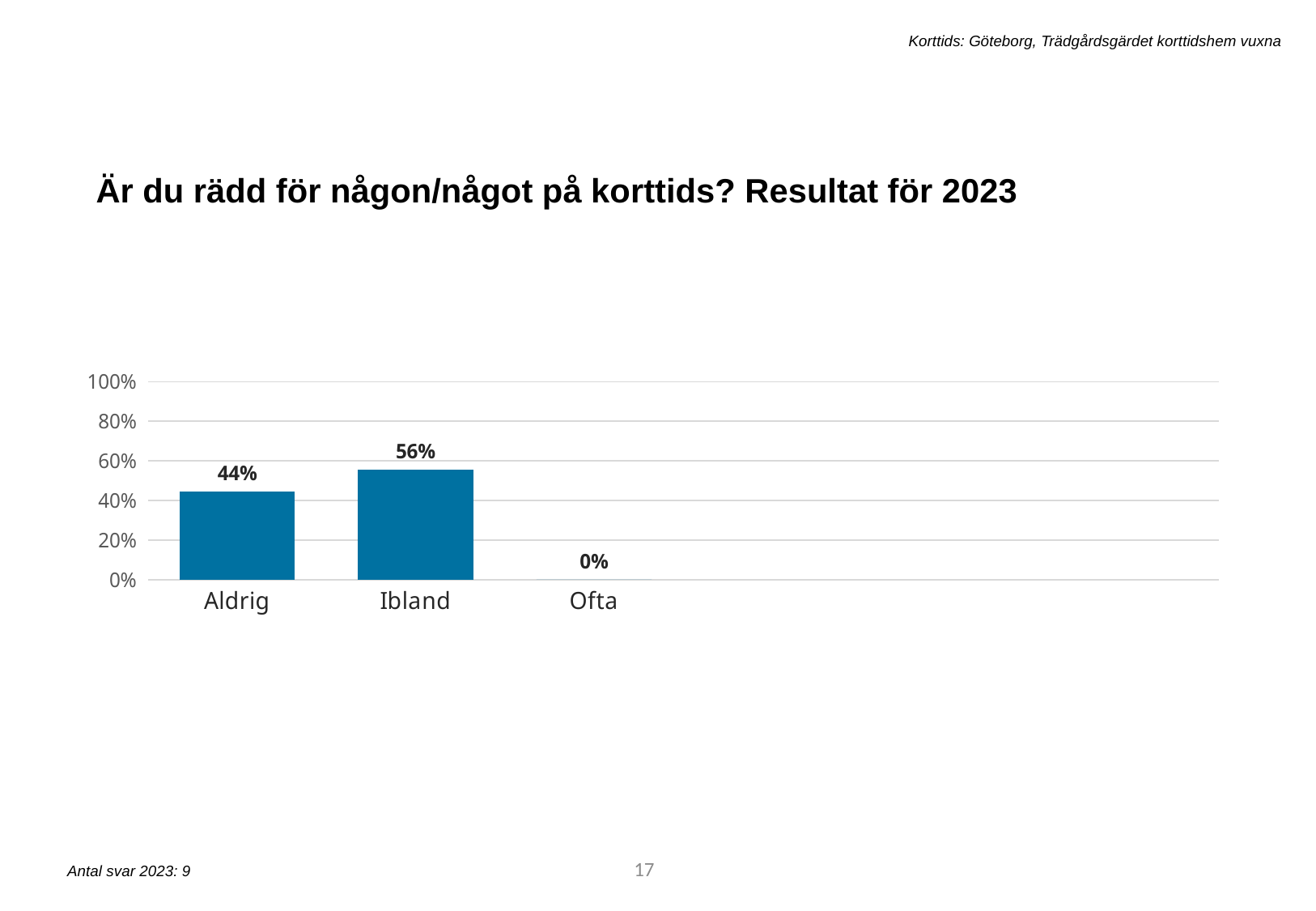
Is the value for Aldrig greater or less than 60%? less What is the value for Ofta? 0% What is the title of the chart? Är du rädd för någon/något på korttids? Resultat för 2023 Which category has the highest value? Ibland What is the difference between the values for Ibland and Aldrig? 12% How many categories are shown on the x axis? 3 What is the highest value shown on the y axis? 100% What is the value for Aldrig? 44% Which is larger, the value for Aldrig or the value for Ibland? Ibland What kind of chart is shown on the slide? bar chart What is the value for Ibland? 56% Which category has the lowest value? Ofta